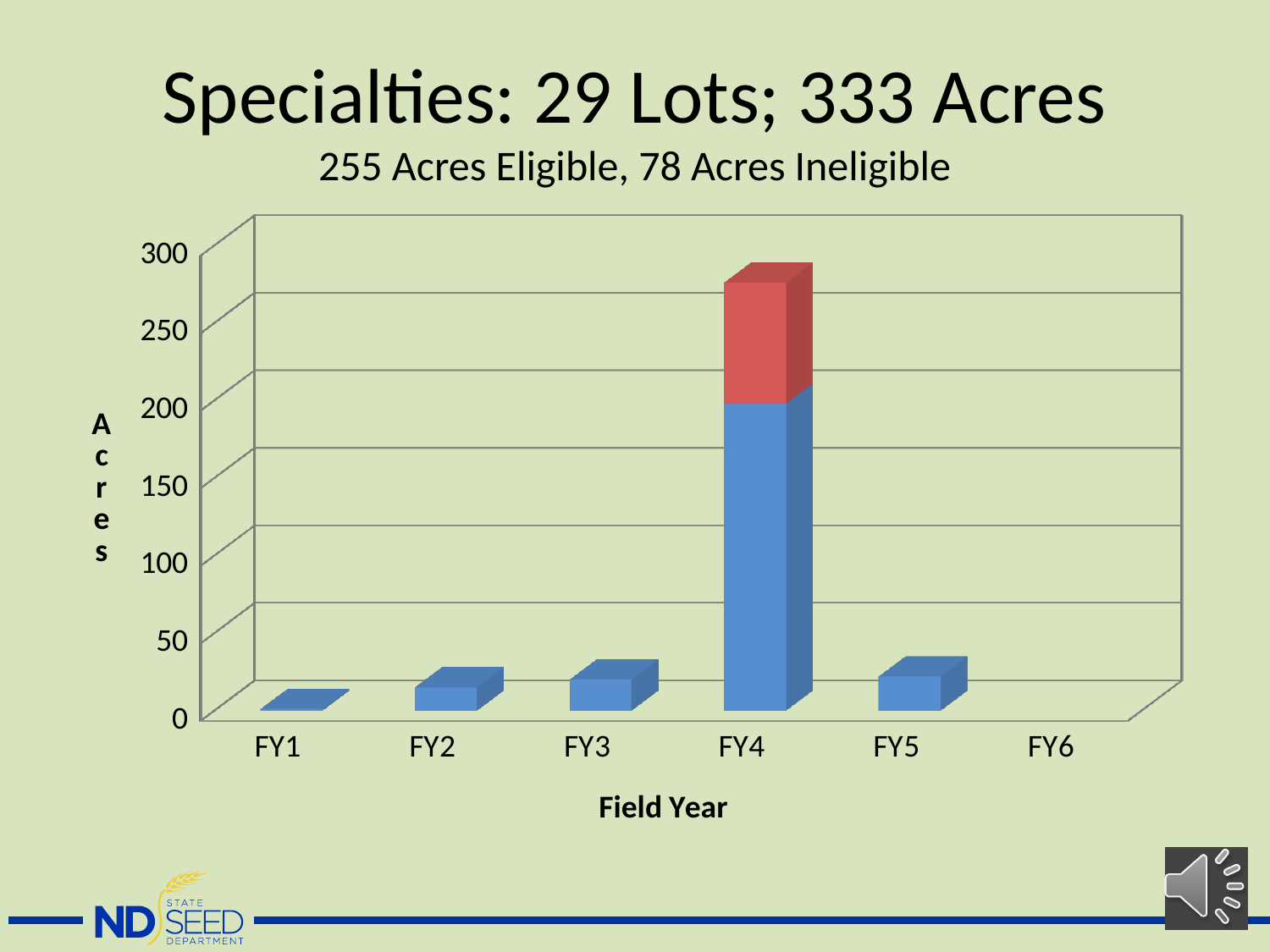
Is the value for FY1 greater or less than 50? less Which has the larger bar, FY2 or FY4? FY4 Is the value for FY2 greater or less than 50? less Which field year is the only one with a red segment in its bar? FY4 What kind of chart is shown on the slide? bar chart Which field year has the tallest bar in the chart? FY4 Which has the larger bar, FY1 or FY3? FY3 How many field years are shown on the x axis of the chart? 6 What is the title of the x axis of the chart? Field Year Is the value for FY5 greater or less than 100? less